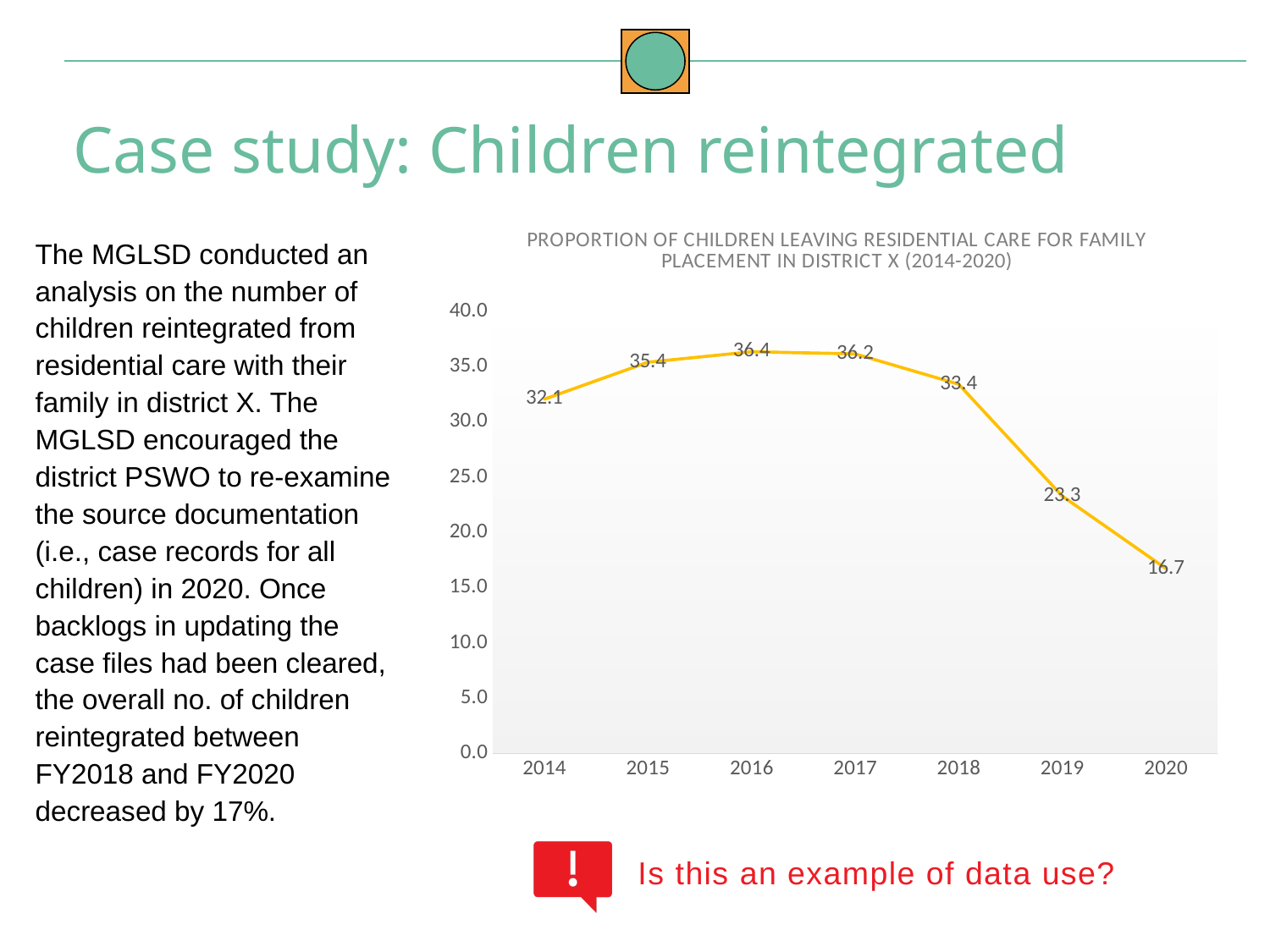
How many years are plotted on the x axis? 7 What is the value for 2014? 32.1 Which is larger, the value for 2015 or the value for 2019? 2015 What kind of chart is shown? line chart What is the title of the chart? PROPORTION OF CHILDREN LEAVING RESIDENTIAL CARE FOR FAMILY PLACEMENT IN DISTRICT X (2014-2020) What is the value for 2018? 33.4 Which year has the highest value? 2016 Do the values rise or fall from 2017 to 2020? fall Is the value for 2019 greater or less than 25.0? less What is the value for 2020? 16.7 Which year has the lowest value? 2020 What is the difference between the values for 2018 and 2020? 16.7